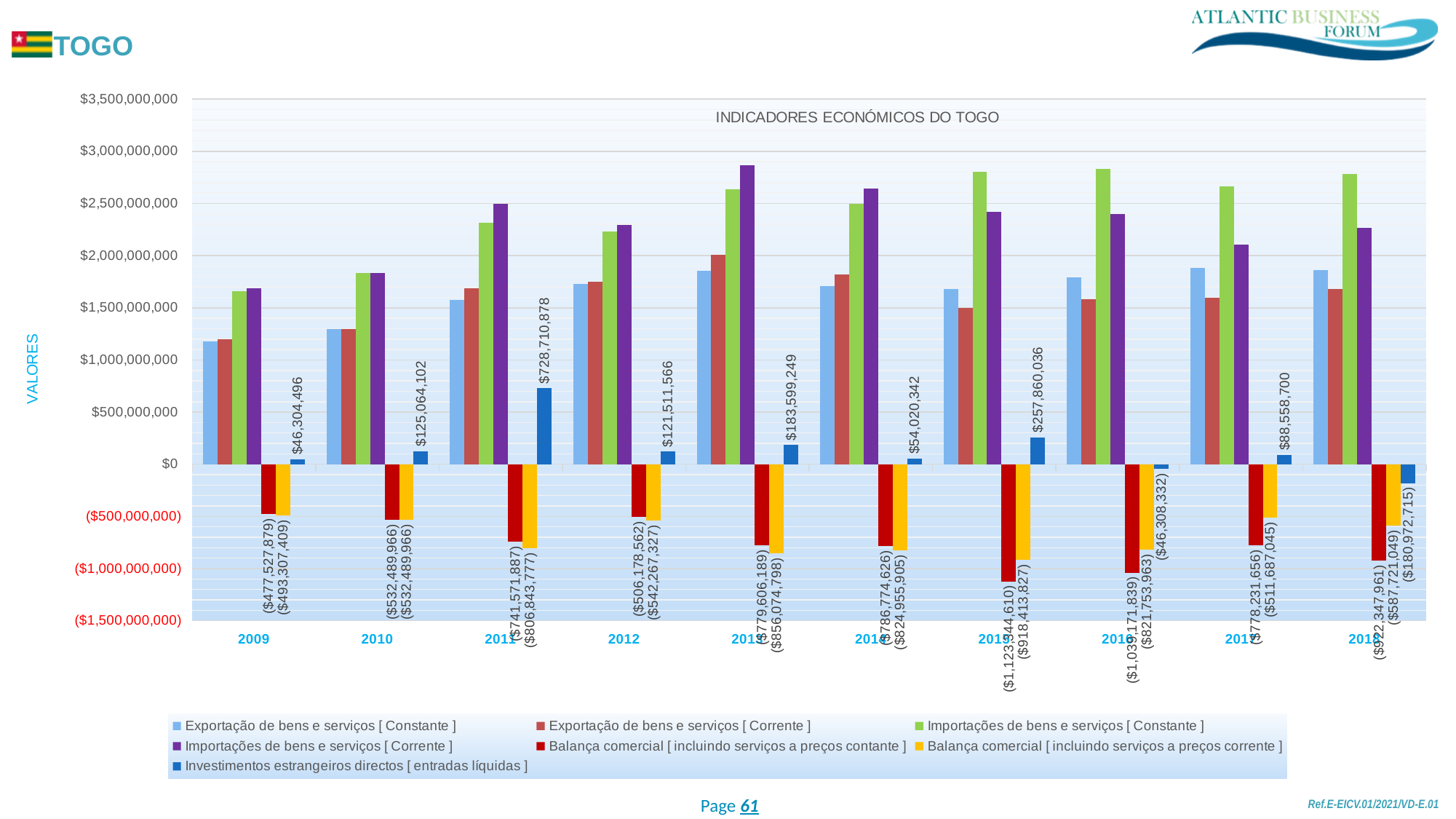
What is the value of Investimentos estrangeiros directos [entradas líquidas] in 2016? ($46,308,332) What is the title of the chart? INDICADORES ECONÓMICOS DO TOGO How many years are shown on the x axis of the chart? 10 Which year has the larger value for Investimentos estrangeiros directos [entradas líquidas], 2013 or 2015? 2015 What kind of chart is shown on the slide? bar chart How many series does the legend list? 7 What is the difference between Investimentos estrangeiros directos [entradas líquidas] in 2010 and in 2009? $78,759,606 Is the value for Importações de bens e serviços [Constante] in 2015 greater or less than $2,500,000,000? greater What is the value of Investimentos estrangeiros directos [entradas líquidas] in 2011? $728,710,878 Is the value for Exportação de bens e serviços [Constante] in 2009 greater or less than $1,500,000,000? less What is the value of Balança comercial [incluindo serviços a preços contante] in 2015? ($1,123,344,610) In which year is Investimentos estrangeiros directos [entradas líquidas] the highest? 2011